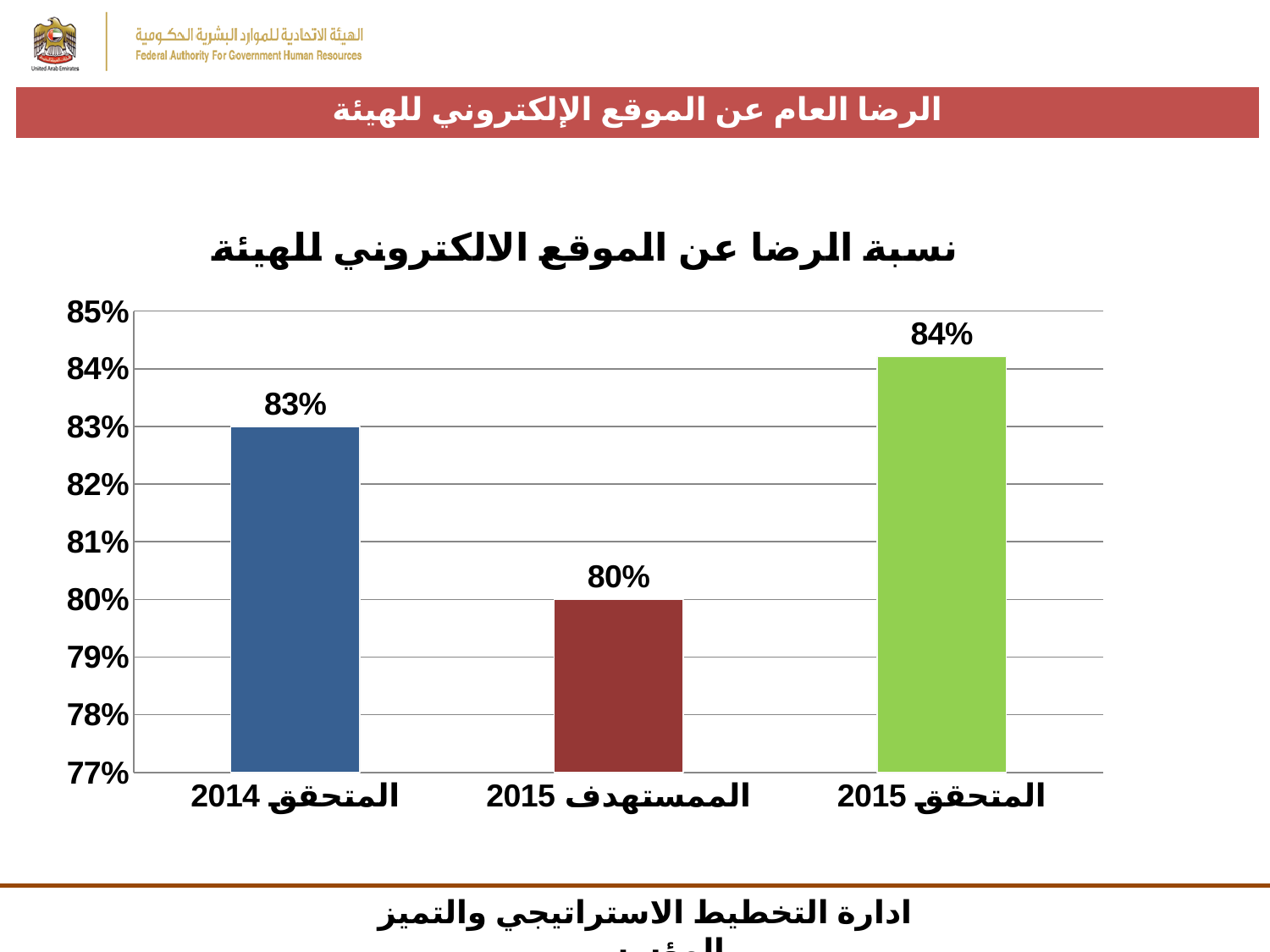
What is the difference between the value for المتحقق 2015 and the value for المستهدف 2015? 4% Which is larger, the value for المتحقق 2014 or the value for المستهدف 2015? المتحقق 2014 What is the difference between the value for المتحقق 2015 and the value for المتحقق 2014? 1% What value is shown for المتحقق 2015 (achieved 2015)? 84% What value is shown for المتحقق 2014 (achieved 2014)? 83% Which category has the lowest value? المستهدف 2015 What value is shown for المستهدف 2015 (target 2015)? 80% What kind of chart is shown on the slide? Bar chart How many categories are plotted in the chart? 3 Which category has the highest value? المتحقق 2015 What is the title of the chart? نسبة الرضا عن الموقع الالكتروني للهيئة What colour is the bar for المتحقق 2015? Green